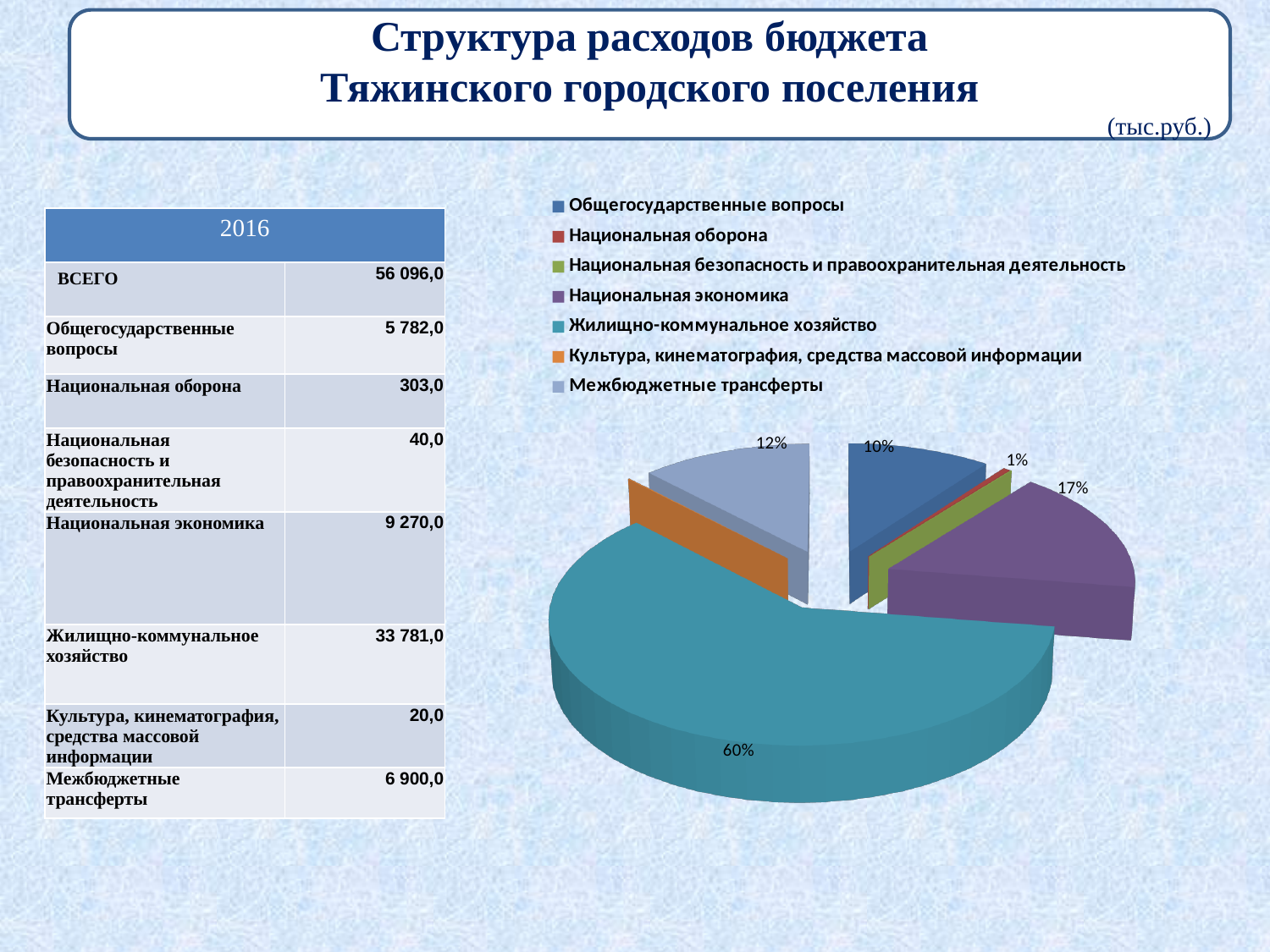
What share of the pie does Межбюджетные трансферты have? 12% What colour is the Жилищно-коммунальное хозяйство slice in the pie chart? Teal What share of the pie does Общегосударственные вопросы have? 10% Which slice is larger: Общегосударственные вопросы or Жилищно-коммунальное хозяйство? Жилищно-коммунальное хозяйство Which category has the largest slice of the pie? Жилищно-коммунальное хозяйство By how many percentage points does the Жилищно-коммунальное хозяйство slice exceed the Национальная экономика slice? 43 percentage points What kind of chart is shown on the slide? Pie chart What share of the pie does Национальная экономика have? 17% How many categories does the legend of the pie chart list? 7 Which slice is larger: Национальная экономика or Межбюджетные трансферты? Национальная экономика Which legend entry is listed first in the pie chart's legend? Общегосударственные вопросы